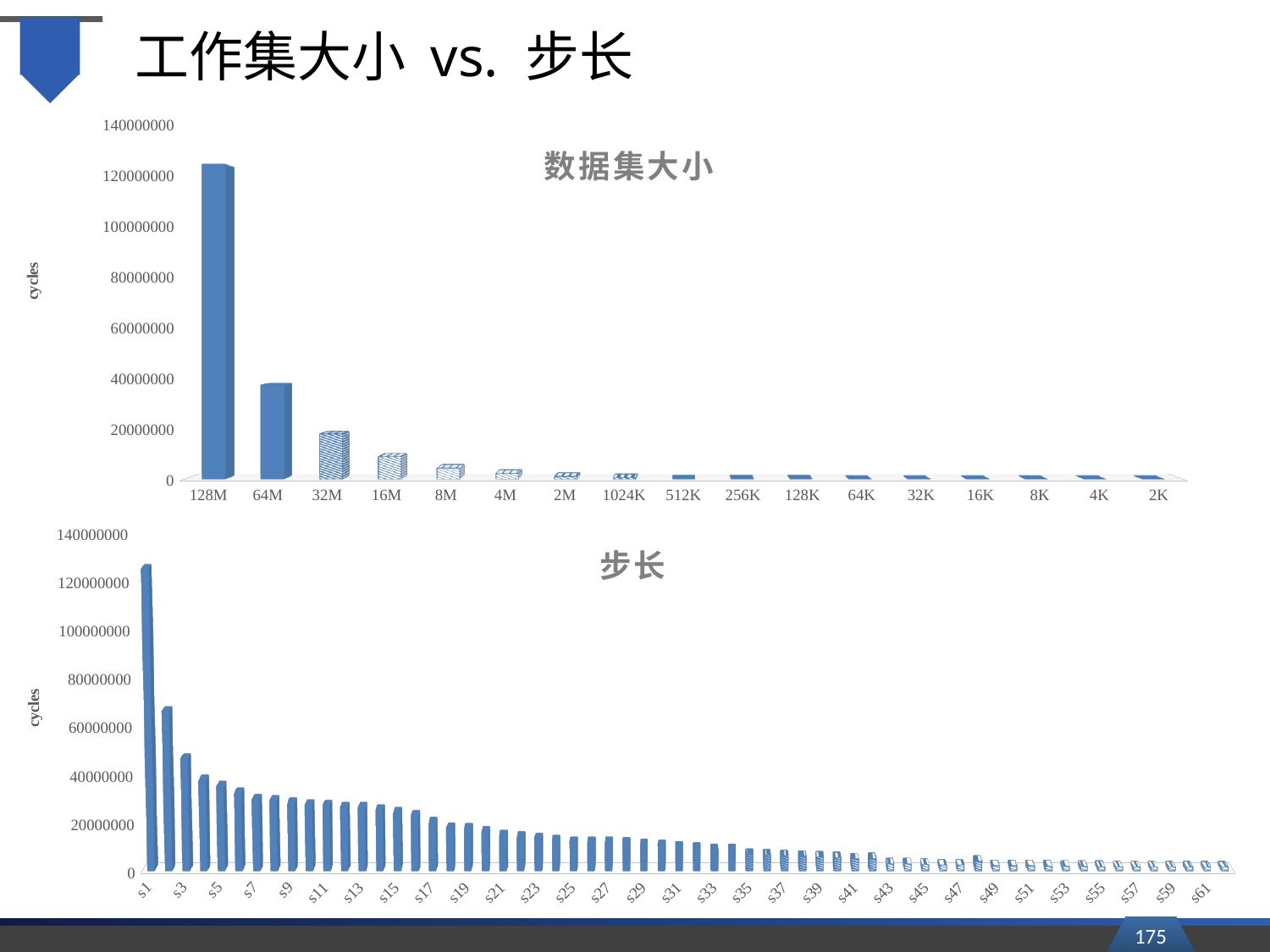
In the top chart (数据集大小), is the value for 64M greater or less than 40000000? less In the bottom chart (步长), is the value for s3 greater or less than 40000000? greater In the bottom chart (步长), do the values rise or fall moving from s1 to s61 along the x axis? fall What kind of chart is the top chart titled 数据集大小? bar chart In the top chart (数据集大小), is the value for 128M greater or less than 100000000? greater In the bottom chart (步长), which category has the highest value? s1 What is the label on the vertical axis of the bottom chart (步长)? cycles In the top chart (数据集大小), which is larger, the value for 128M or the value for 64M? 128M In the top chart (数据集大小), do the values rise or fall moving from 128M to 2K along the x axis? fall In the top chart (数据集大小), which category has the highest value? 128M In the top chart (数据集大小), how many categories are shown on the x axis? 17